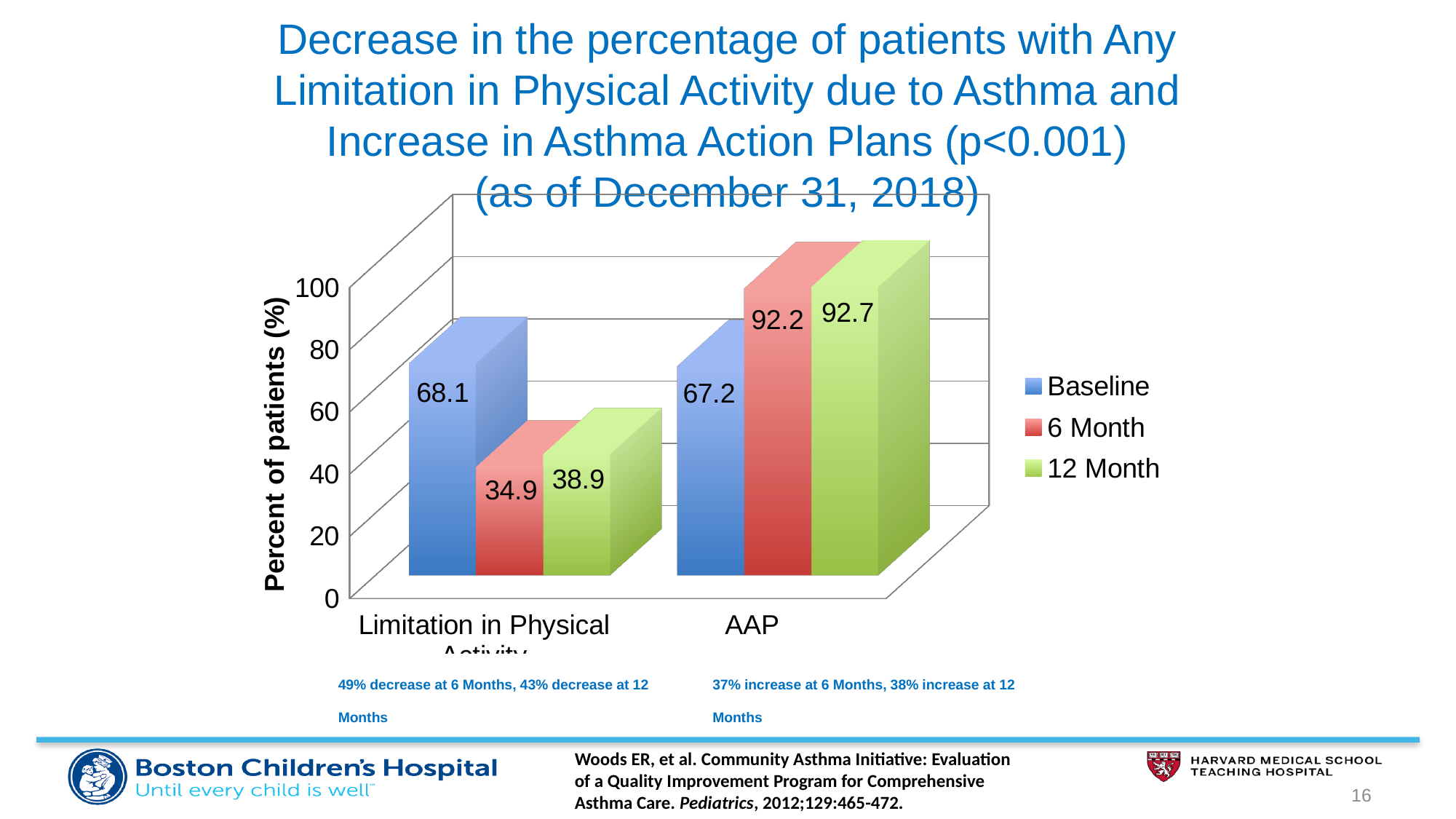
How many categories are shown on the x axis? 2 How many series does the legend list? 3 Which is larger for AAP: the Baseline value or the 6 Month value? 6 Month What is the difference between the Baseline and 6 Month values for Limitation in Physical Activity? 33.2 What is the Baseline value for Limitation in Physical Activity? 68.1 What is the Baseline value for AAP? 67.2 What is the label of the vertical axis? Percent of patients (%) What kind of chart is shown on the slide? Bar chart What is the 12 Month value for Limitation in Physical Activity? 38.9 Which series has the highest value for AAP? 12 Month Which series has the lowest value for Limitation in Physical Activity? 6 Month What is the 6 Month value for AAP? 92.2